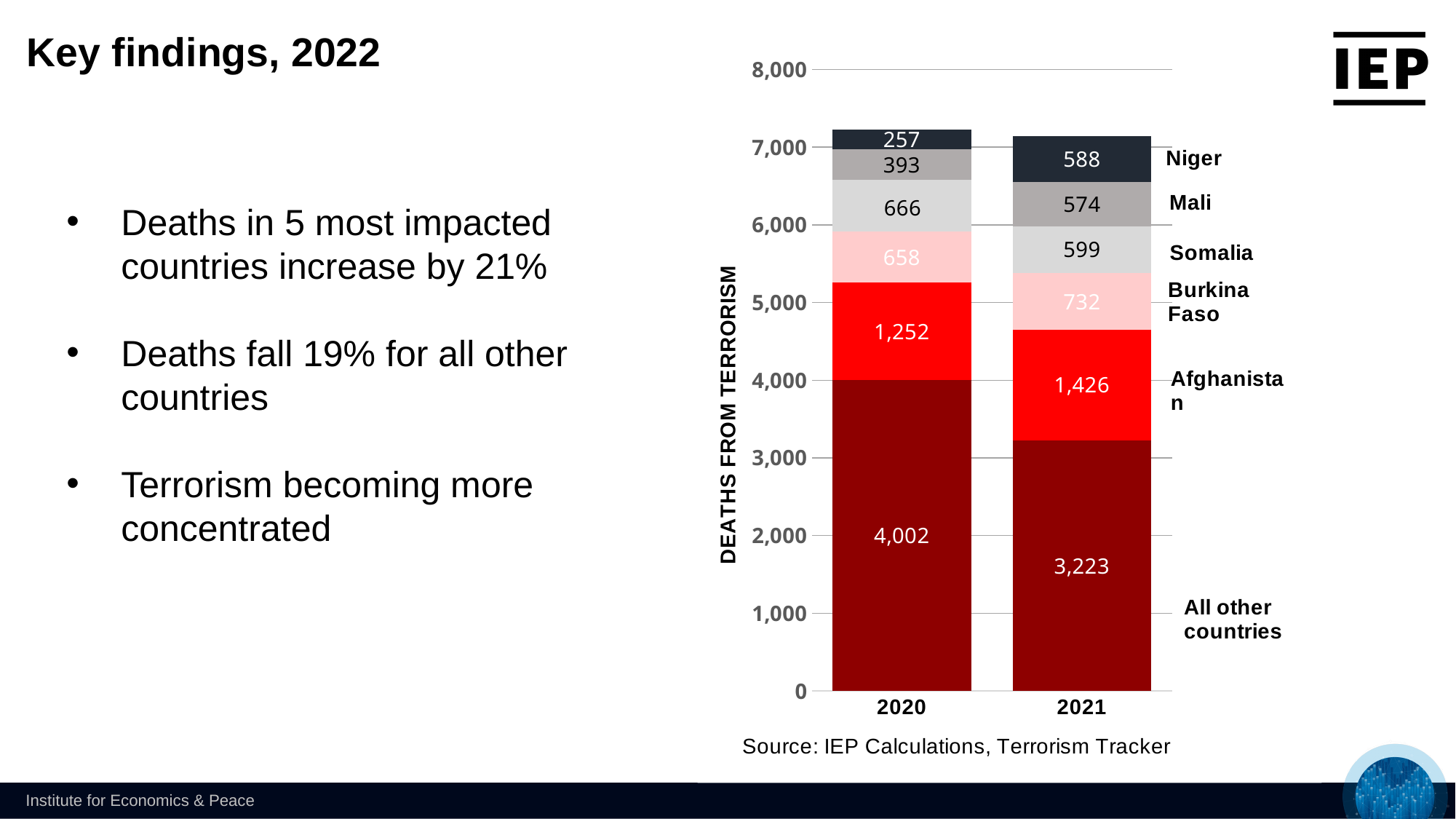
What is the total of the stacked bar for 2020? 7,228 What is the value for Niger in 2021? 588 What is the value for All other countries in 2020? 4,002 By how much did the value for Niger change from 2020 to 2021? 331 How many years (bars) are shown on the x axis? 2 How many deaths from terrorism are shown for Afghanistan in 2021? 1,426 What is the difference between the All other countries values for 2020 and 2021? 779 What is the value for Somalia in 2020? 666 Which year has the larger value for Burkina Faso, 2020 or 2021? 2021 What kind of chart is shown on the slide? Stacked bar chart How many country groups (series) are labelled on the chart? 6 Which year has the larger value for Mali, 2020 or 2021? 2021